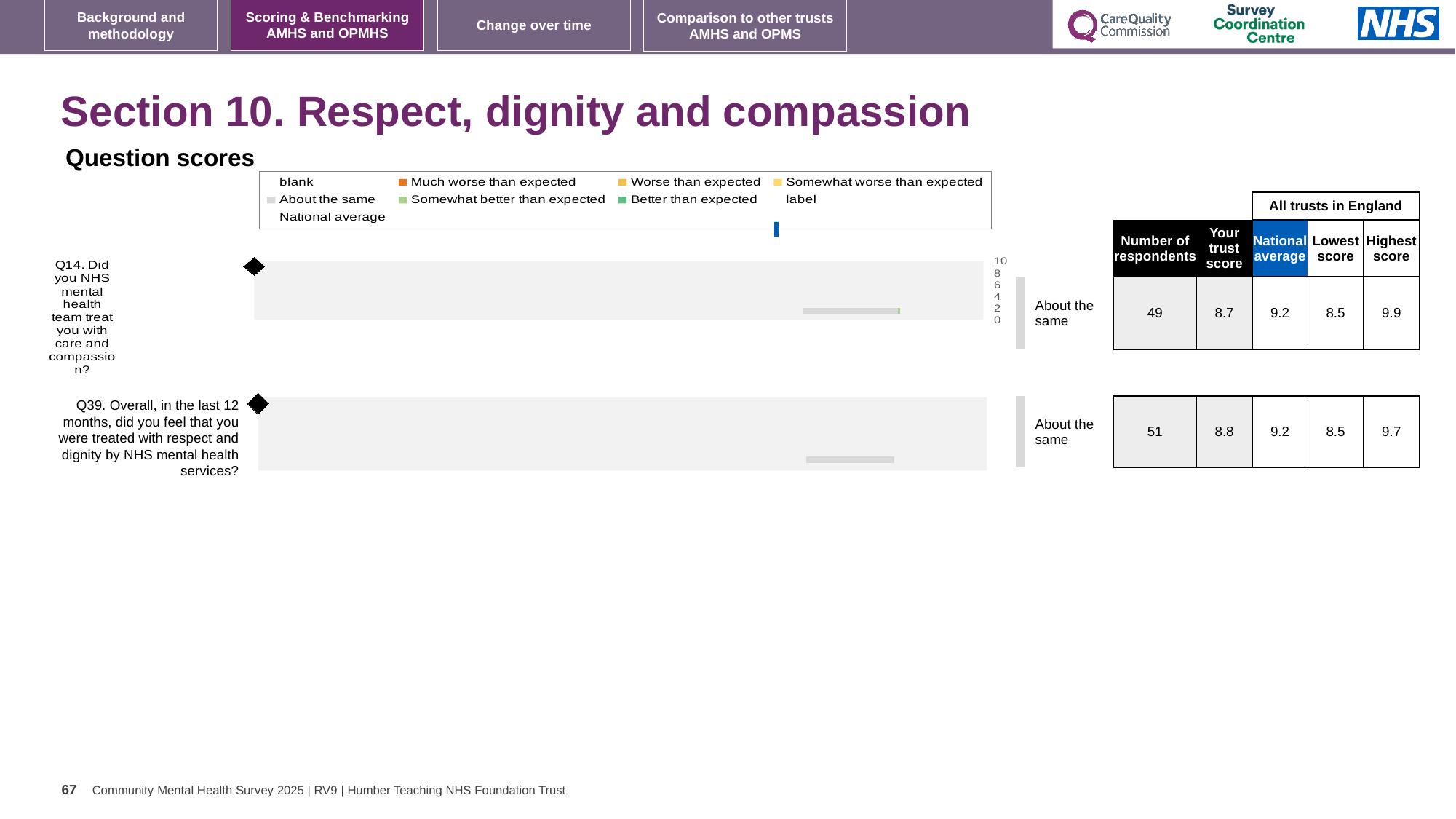
What is the highest score among all trusts in England for Q39? 9.7 What kind of chart is used to show the question scores? Bar chart What is the trust score for Q39 (respect and dignity)? 8.8 What is the difference between the highest score for Q14 and the highest score for Q39? 0.2 How many respondents answered Q39? 51 What is the trust score for Q14 (care and compassion)? 8.7 What benchmark category is shown for Q14? About the same How many respondents answered Q14? 49 By how much is the national average for Q14 higher than the trust score for Q14? 0.5 What is the national average score for Q14? 9.2 Which question has the higher trust score, Q14 or Q39? Q39 How many questions are plotted on the slide? 2